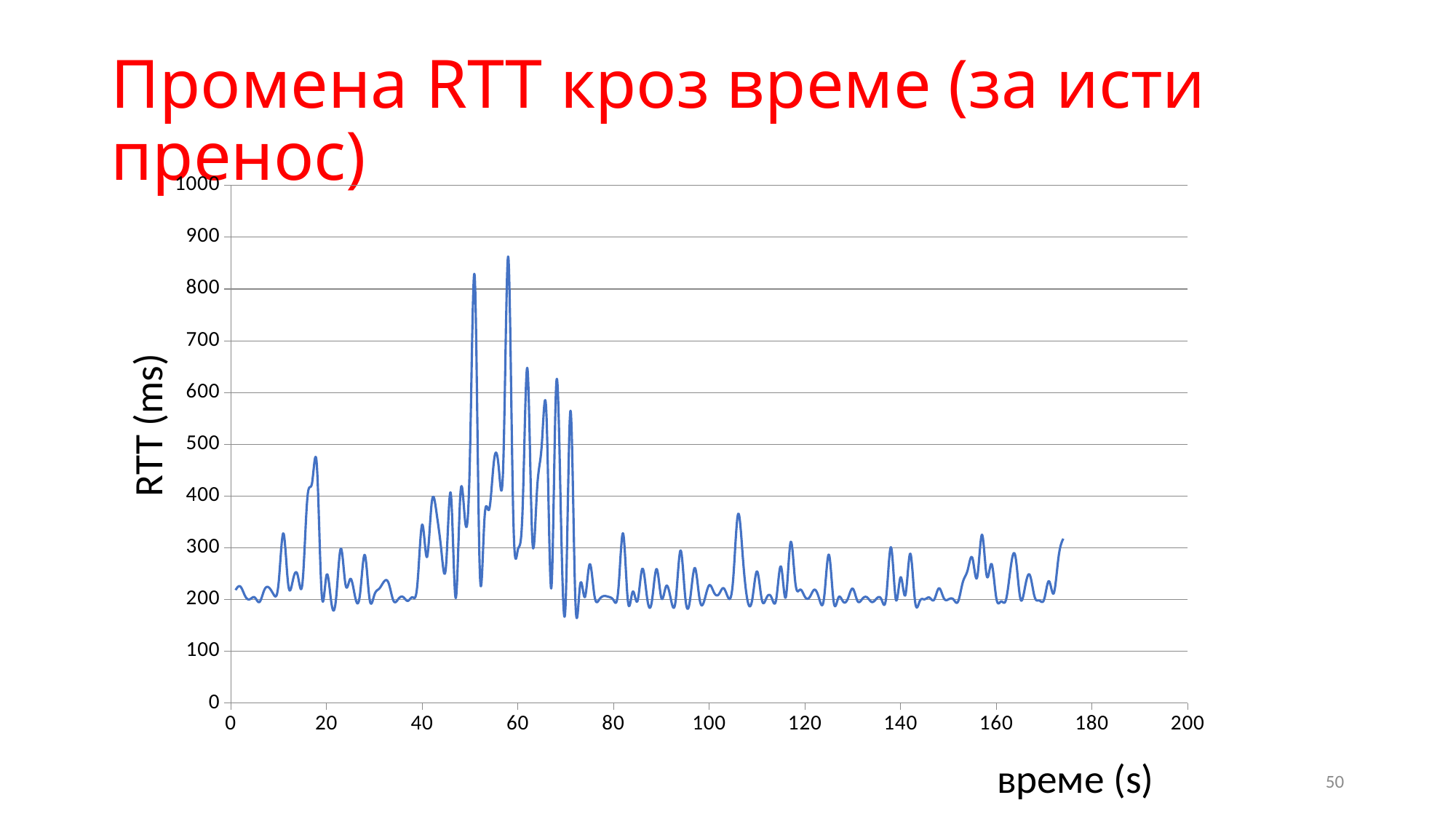
What kind of chart is shown on the slide? line chart In which time range does the RTT reach its highest peak: between 40 and 80 s, or between 120 and 160 s? between 40 and 80 s What is the title of the chart on the slide? Промена RTT кроз време (за исти пренос) Is the RTT value at around 140 s greater or less than 400? less What is the label of the vertical axis? RTT (ms) Is the highest RTT value on the chart greater or less than 900? less Is the RTT value at around 18 s greater or less than 400? greater What is the maximum value shown on the vertical axis? 1000